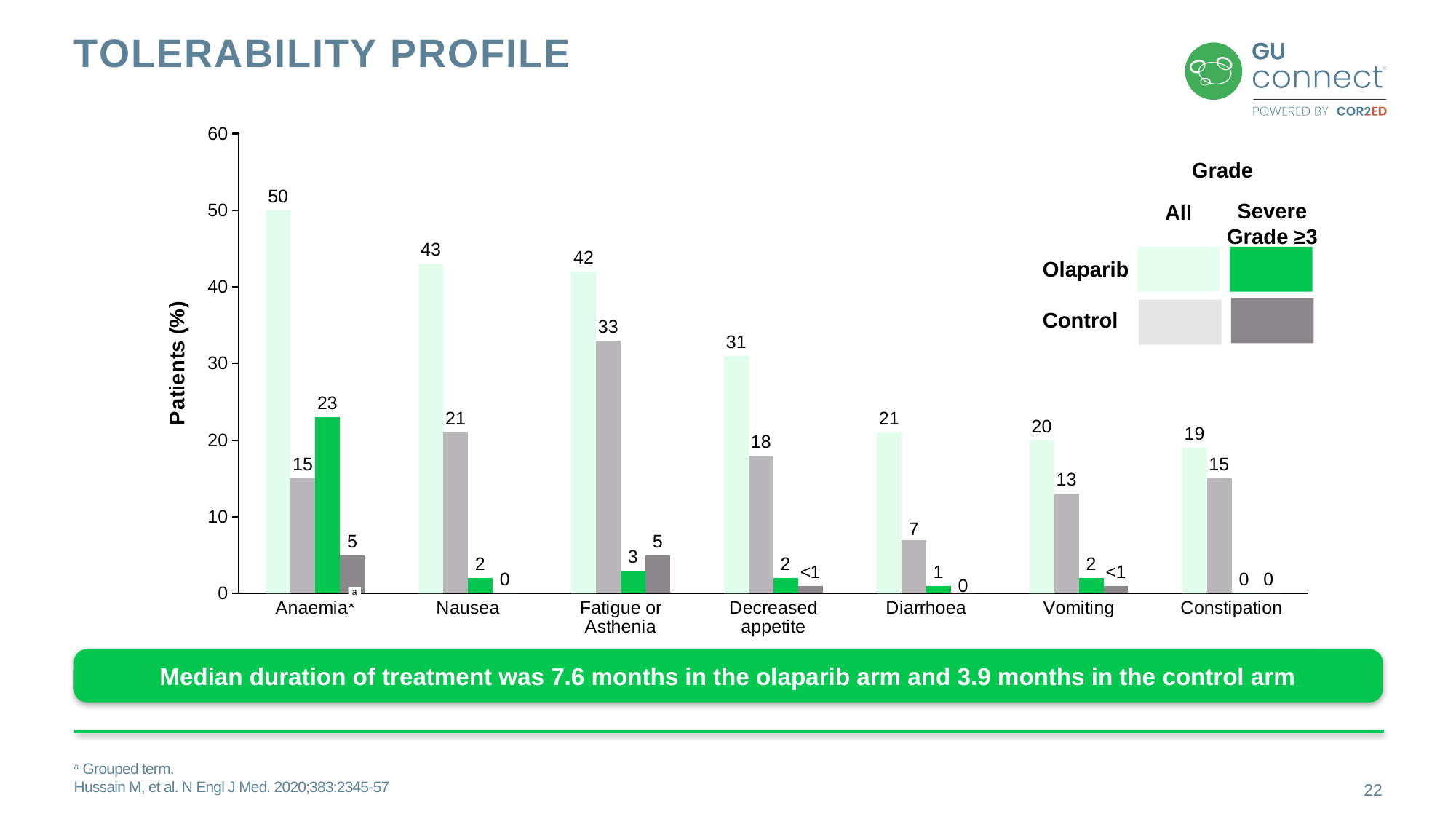
How many series does the legend show? 4 For all-grade fatigue or asthenia, which arm has the larger value, olaparib or control? Olaparib What kind of chart is shown on the slide? Bar chart Which adverse event has the lowest all-grade value in the olaparib arm? Constipation How many adverse event categories are shown on the x axis? 7 What percentage of control patients had fatigue or asthenia of any grade? 33 What is the difference between the all-grade nausea values for olaparib and control? 22 What percentage of patients had anaemia of any grade in the olaparib arm? 50 What is the value for severe (grade ≥3) vomiting in the control arm? <1 Which adverse event has the highest all-grade value in the olaparib arm? Anaemia What is the label of the y axis? Patients (%) What is the value for severe (grade ≥3) anaemia in the olaparib arm? 23